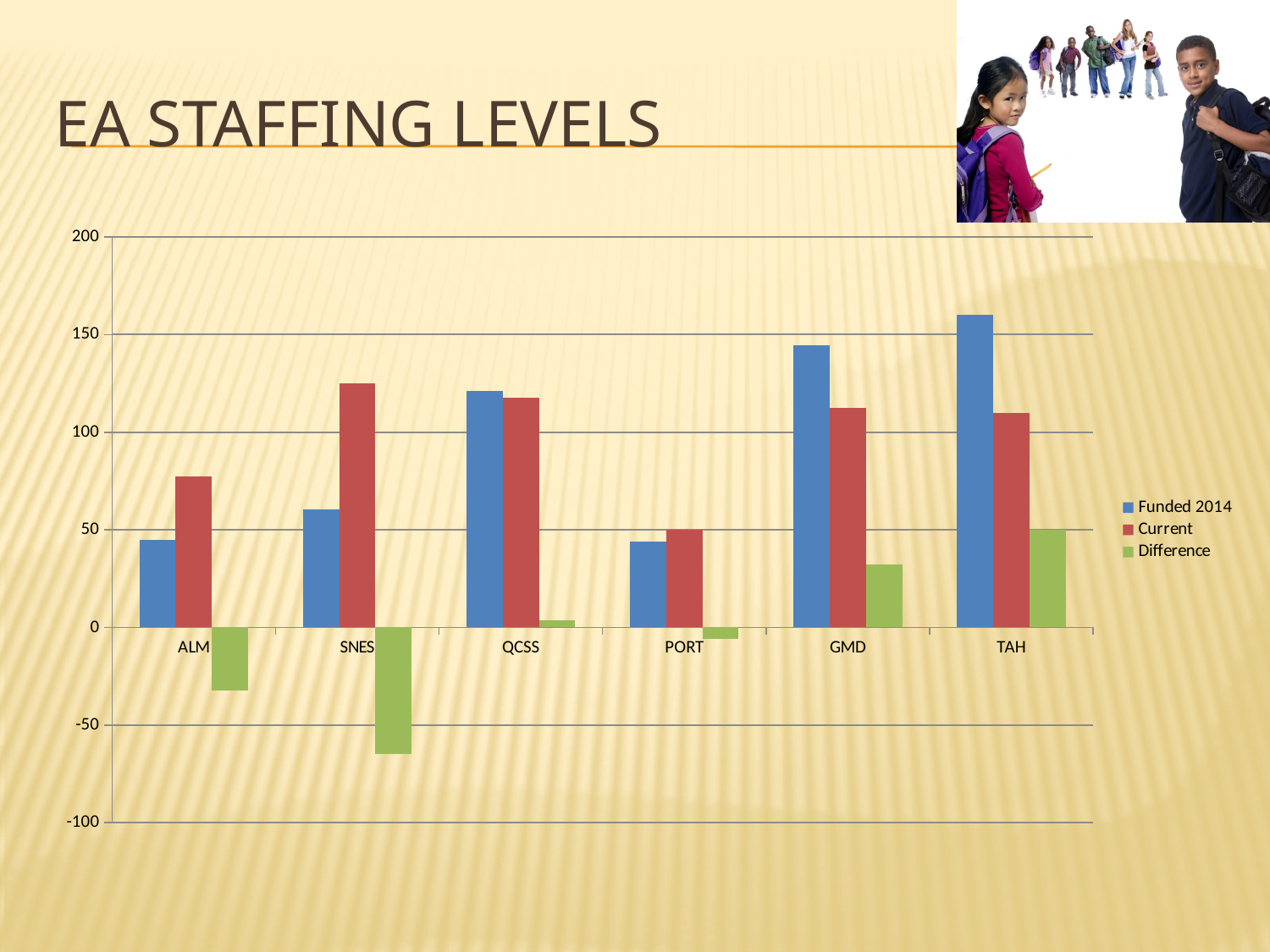
Which school has the highest Current value? SNES What kind of chart is shown on the slide? bar chart Which school has the lowest Difference value? SNES How many series does the chart's legend list? 3 Is the Funded 2014 value for GMD greater or less than 100? greater For ALM, which is larger: the Funded 2014 value or the Current value? Current Which school has the lowest Current value? PORT How many schools (categories) are shown on the x axis of the chart? 6 What is the title of the slide containing the chart? EA STAFFING LEVELS Is the Difference value for SNES greater or less than -50? less Which school has the highest Funded 2014 value? TAH Which school has the highest Difference value? TAH